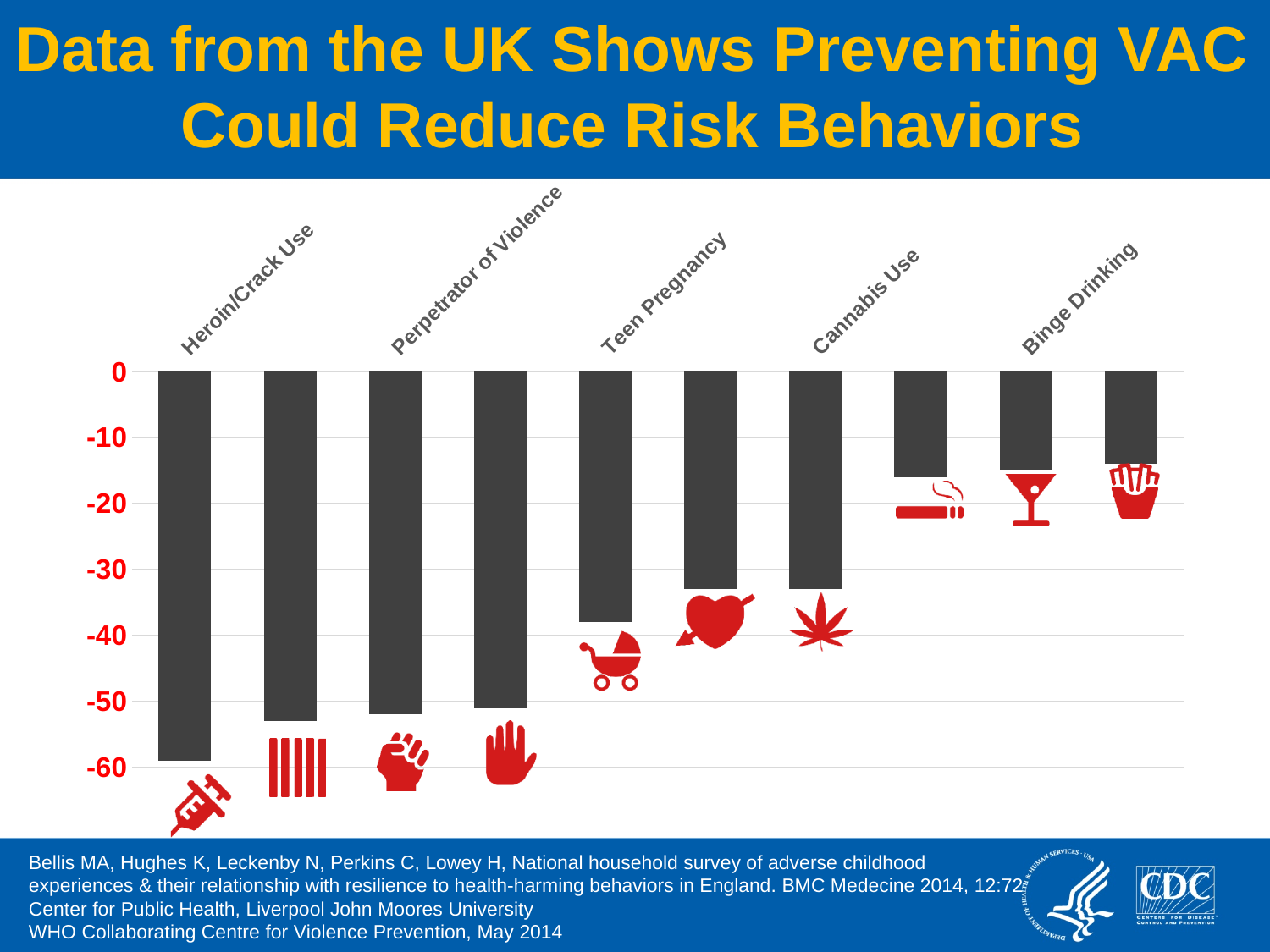
What kind of chart is shown on the slide? bar chart What is the lowest value shown on the vertical axis? -60 Is the value of the bar with the cigarette icon greater or less than -20? greater Which has the more negative value, the leftmost bar or the rightmost bar? the leftmost bar Is the value of the bar with the cannabis leaf icon greater or less than -30? less Is the value of the leftmost bar greater or less than -50? less Which bar has the lowest (most negative) value? the leftmost bar (Heroin/Crack Use, syringe icon) How many bars are plotted in the chart? 10 What is the title of the slide containing the chart? Data from the UK Shows Preventing VAC Could Reduce Risk Behaviors Do the bar values become more negative or less negative moving from left to right across the chart? less negative